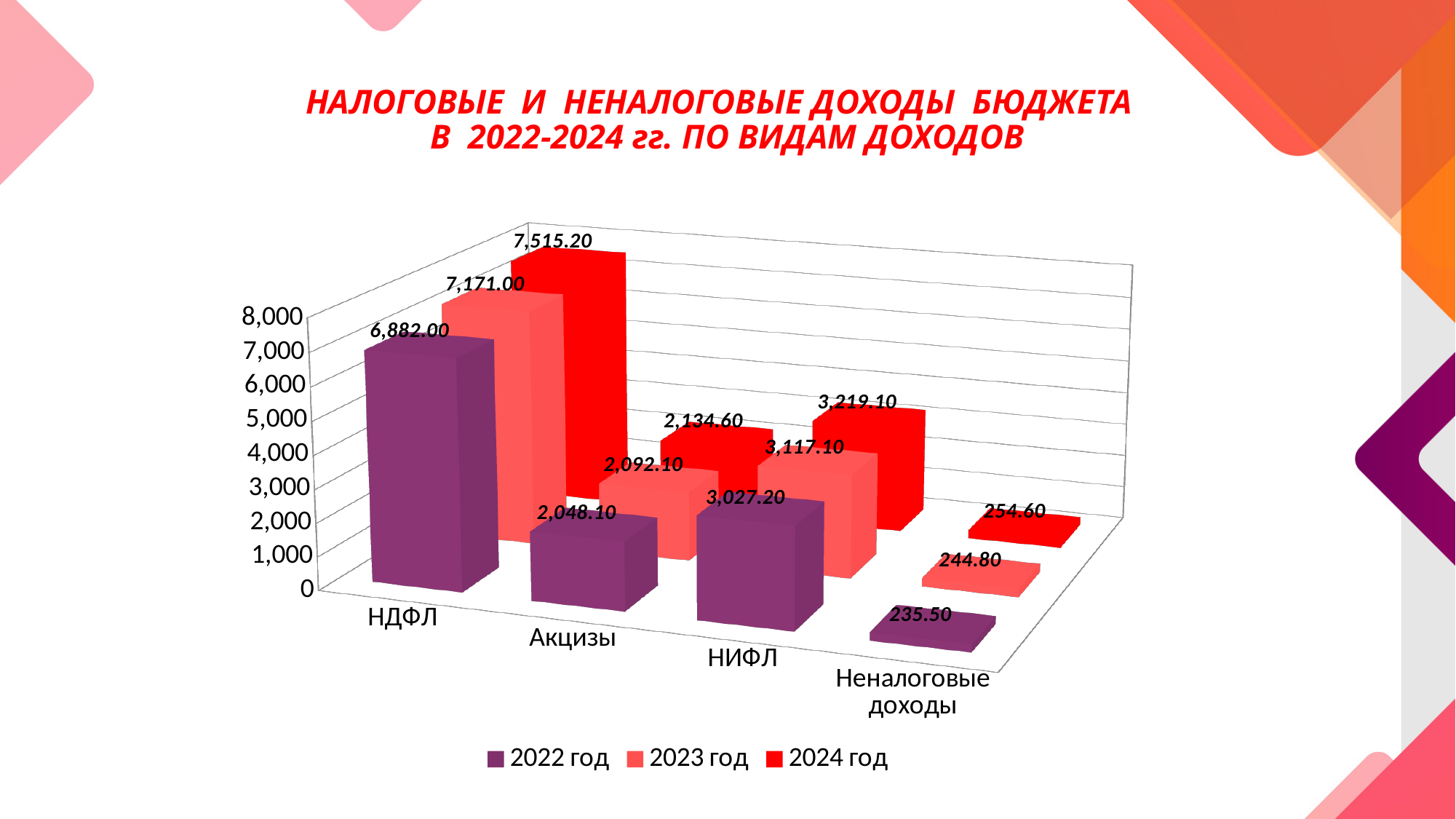
What is the difference between the 2024 год and 2022 год values for НДФЛ? 633.20 What is the value for НДФЛ in the 2024 год series? 7,515.20 Which is larger: the 2023 год value for НИФЛ or the 2024 год value for Акцизы? 2023 год value for НИФЛ What is the value for Акцизы in the 2022 год series? 2,048.10 What is the value for НИФЛ in the 2023 год series? 3,117.10 Which category has the highest value in the 2022 год series? НДФЛ What kind of chart is shown on the slide? Bar chart How many categories are shown on the x axis? 4 Which category has the lowest value in the 2023 год series? Неналоговые доходы Do the values for Неналоговые доходы rise or fall from 2022 год to 2024 год? Rise How many series does the legend list? 3 What is the value for Неналоговые доходы in the 2024 год series? 254.60